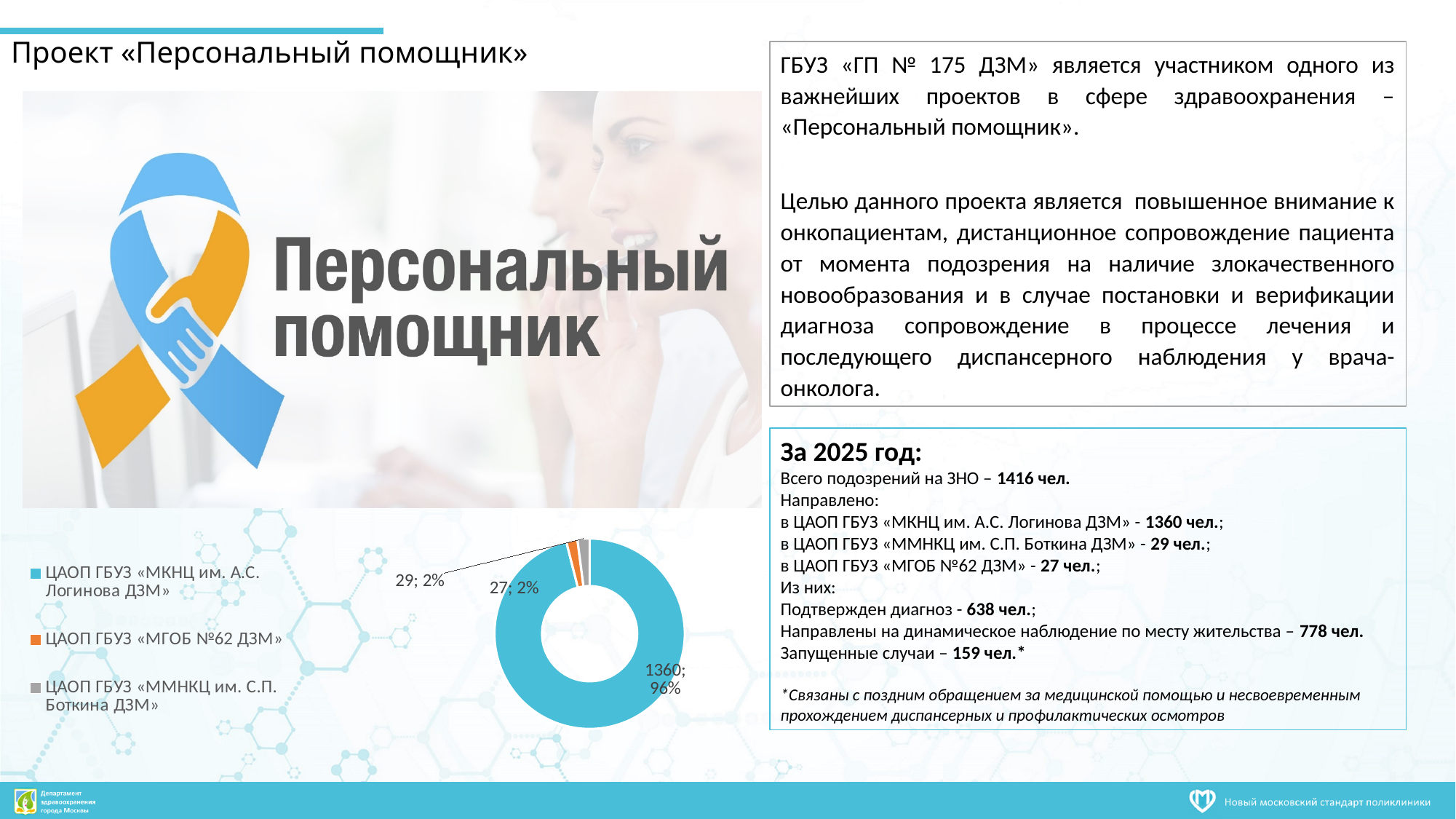
What value is shown for ЦАОП ГБУЗ «МГОБ №62 ДЗМ» in the donut chart? 27 What is the total of all three values shown in the donut chart? 1416 What share of the donut chart does ЦАОП ГБУЗ «МГОБ №62 ДЗМ» represent? 2% How many entries does the legend of the donut chart list? 3 How many slices does the donut chart have? 3 What share of the donut chart does ЦАОП ГБУЗ «МКНЦ им. А.С. Логинова ДЗМ» represent? 96% What value is shown for ЦАОП ГБУЗ «МКНЦ им. А.С. Логинова ДЗМ» in the donut chart? 1360 What value is shown for ЦАОП ГБУЗ «ММНКЦ им. С.П. Боткина ДЗМ» in the donut chart? 29 What kind of chart is shown at the bottom left of the slide? Pie (donut) chart Which colour represents ЦАОП ГБУЗ «МГОБ №62 ДЗМ» in the donut chart? Orange What is the difference between the values for ЦАОП ГБУЗ «МКНЦ им. А.С. Логинова ДЗМ» and ЦАОП ГБУЗ «ММНКЦ им. С.П. Боткина ДЗМ» in the donut chart? 1331 Which category has the largest slice in the donut chart? ЦАОП ГБУЗ «МКНЦ им. А.С. Логинова ДЗМ»